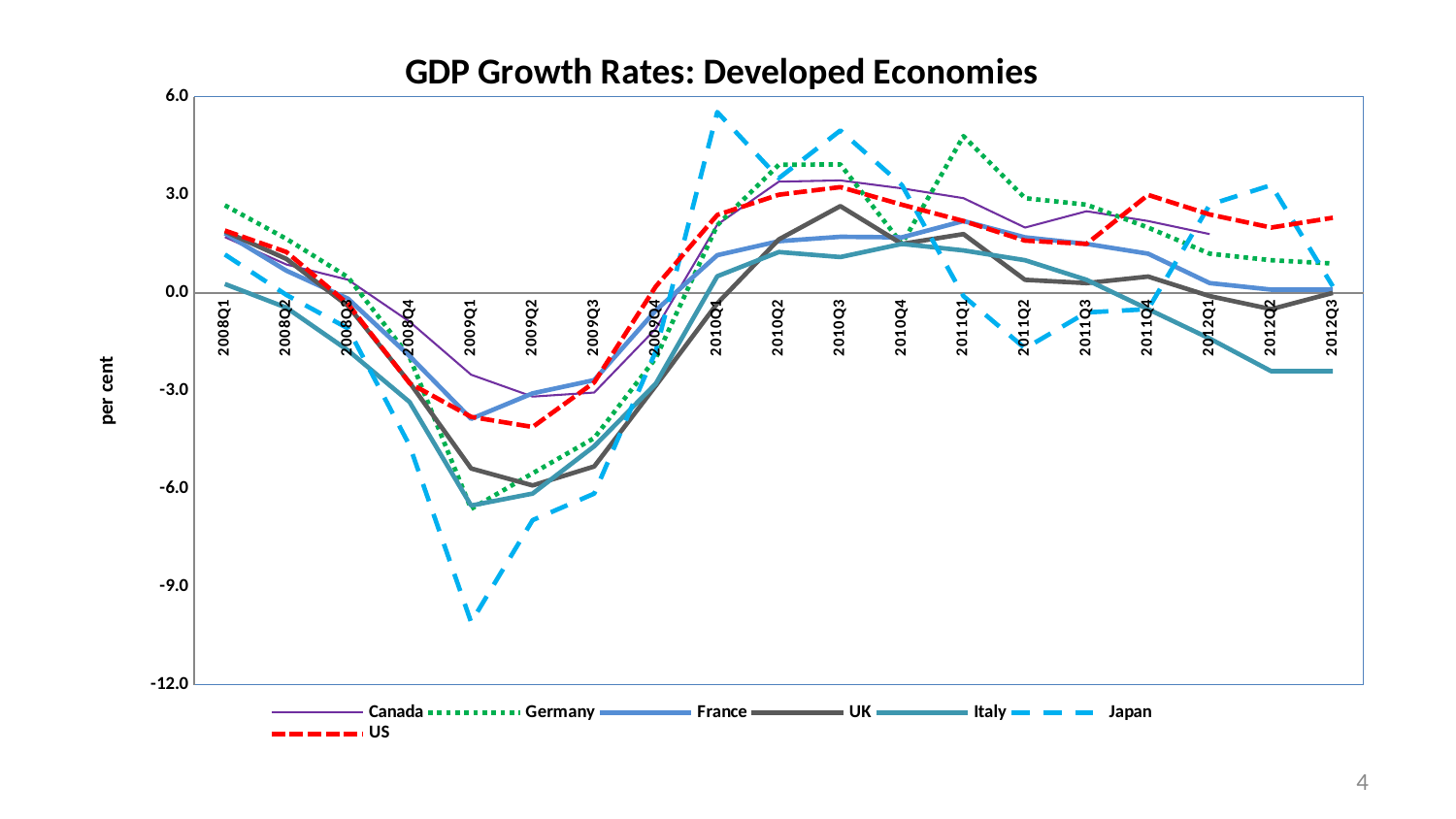
What kind of chart is shown on the slide? line chart What is the label on the vertical axis? per cent Is the value for Germany in 2011Q1 greater or less than 3.0? greater How many quarters are shown along the x axis? 19 Does the Japan series rise or fall from 2008Q1 to 2009Q1? fall Which series has the highest value in 2010Q1? Japan In 2012Q3, which is larger: the value for Germany or the value for Italy? Germany Is the value for Japan in 2009Q1 greater or less than -9.0? less Which series has the highest value in 2011Q1? Germany What is the title of the chart? GDP Growth Rates: Developed Economies Which series has the lowest value in 2009Q1? Japan How many series does the legend list? 7